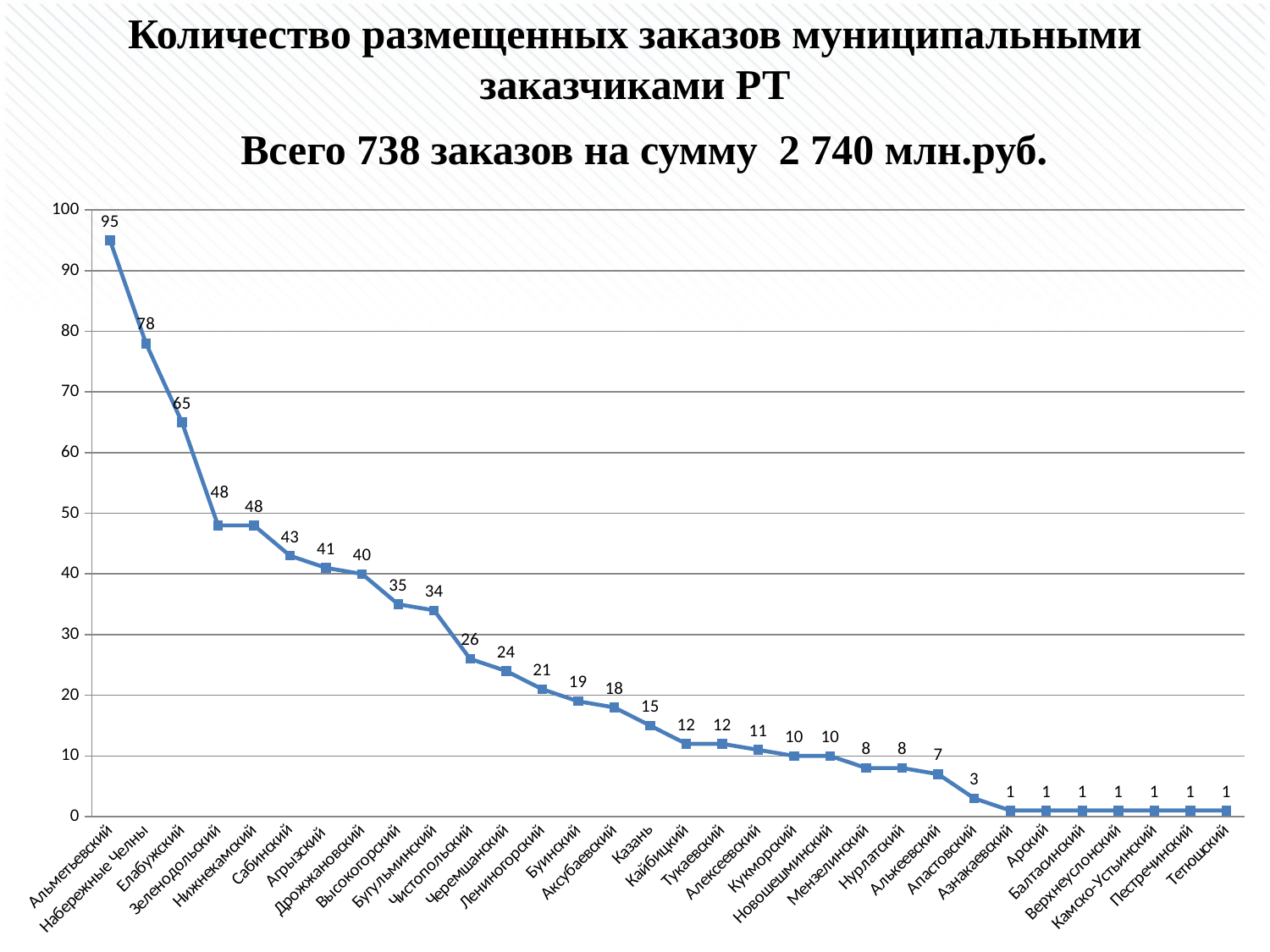
What is the value for Набережные Челны? 78 What total number of orders is stated in the slide title? 738 What is the difference between the values for Альметьевский and Елабужский? 30 Which has a larger value, Сабинский or Бугульминский? Сабинский How many categories have a value of 1? 7 What is the value for Альметьевский? 95 What type of chart is shown on the slide? line chart Which category has the highest value? Альметьевский What is the value for Казань? 15 What is the difference between the values for Чистопольский and Черемшанский? 2 What is the value for Апастовский? 3 Do the values rise or fall from left to right along the x axis? fall